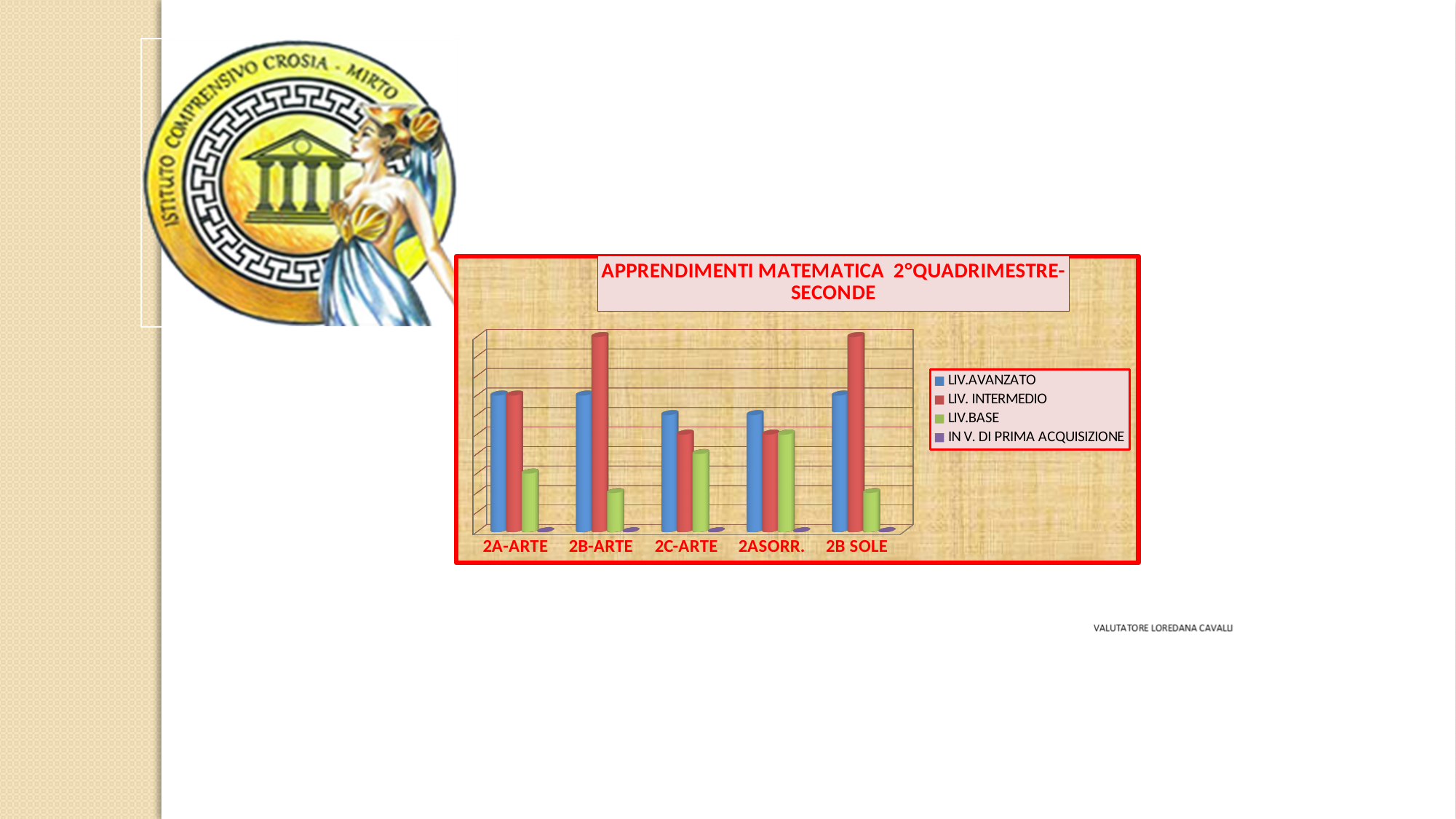
Which series has the lowest bar for 2A-ARTE? IN V. DI PRIMA ACQUISIZIONE What is the title of the chart? APPRENDIMENTI MATEMATICA 2°QUADRIMESTRE- SECONDE How many series does the chart legend list? 4 What kind of chart is shown on the slide? Bar chart For 2A-ARTE, which is larger: LIV.AVANZATO or LIV.BASE? LIV.AVANZATO For 2C-ARTE, which is larger: LIV.AVANZATO or LIV.BASE? LIV.AVANZATO Which series has the tallest bar for 2ASORR.? LIV.AVANZATO Which series has the tallest bar for 2B-ARTE? LIV. INTERMEDIO For 2B SOLE, which is larger: LIV. INTERMEDIO or LIV.BASE? LIV. INTERMEDIO Which class has the highest LIV.BASE bar? 2ASORR. How many classes (categories) are shown on the x axis of the chart? 5 Which series is shown in green in the chart? LIV.BASE